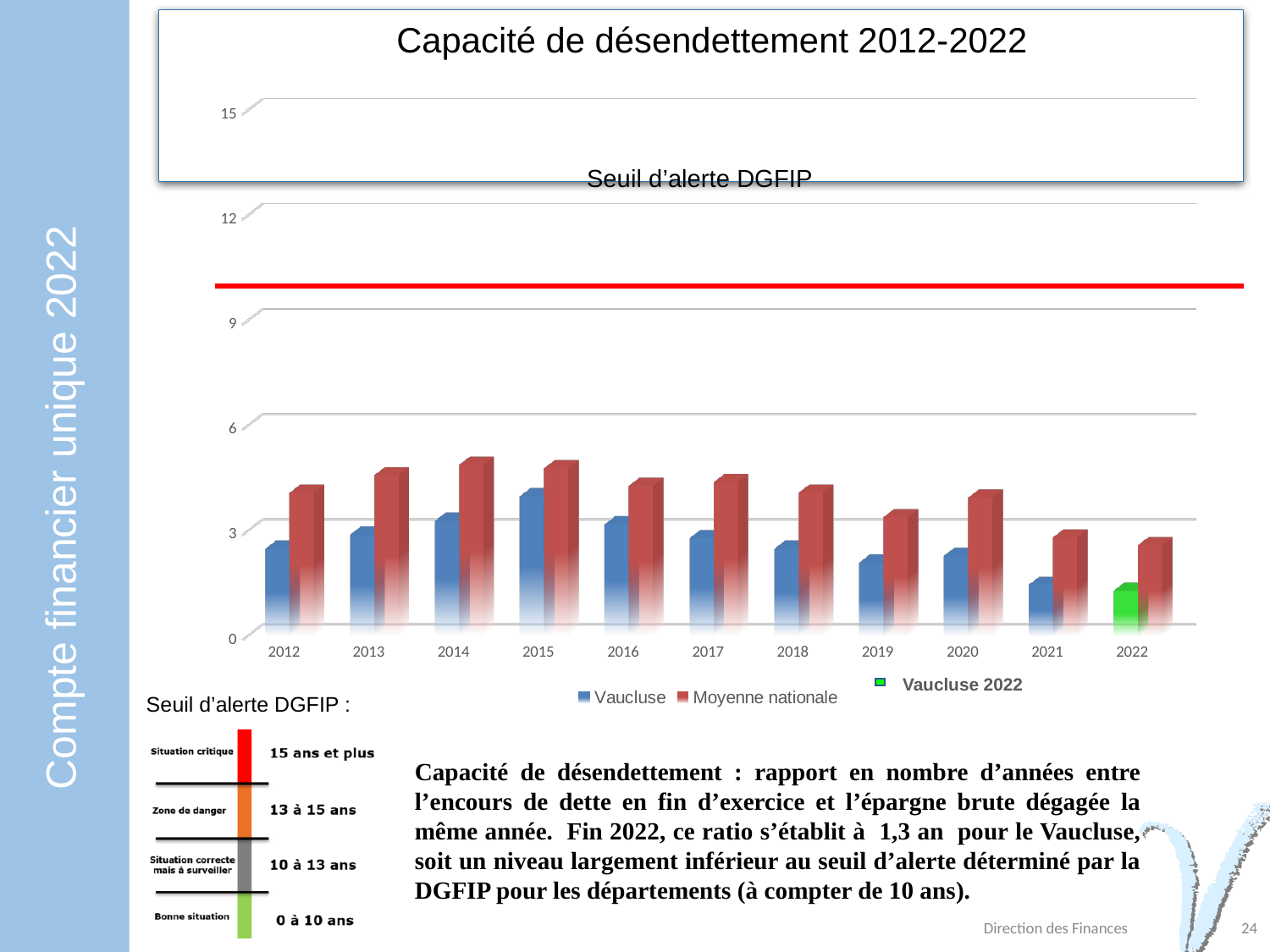
In 2012, which is larger: the Vaucluse value or the Moyenne nationale value? Moyenne nationale What is the title of the chart? Capacité de désendettement 2012-2022 Is the Moyenne nationale value for 2019 greater or less than 3? greater How many years are shown along the x axis of the chart? 11 In which year is the Vaucluse value highest? 2015 What kind of chart is shown on the slide? bar chart Is the Vaucluse value for 2022 greater or less than 3? less What does the horizontal red line on the chart represent? Seuil d'alerte DGFIP Is the Vaucluse value for 2015 greater or less than 3? greater How many series does the chart legend list? 2 In 2019, which is larger: the Vaucluse value or the Moyenne nationale value? Moyenne nationale